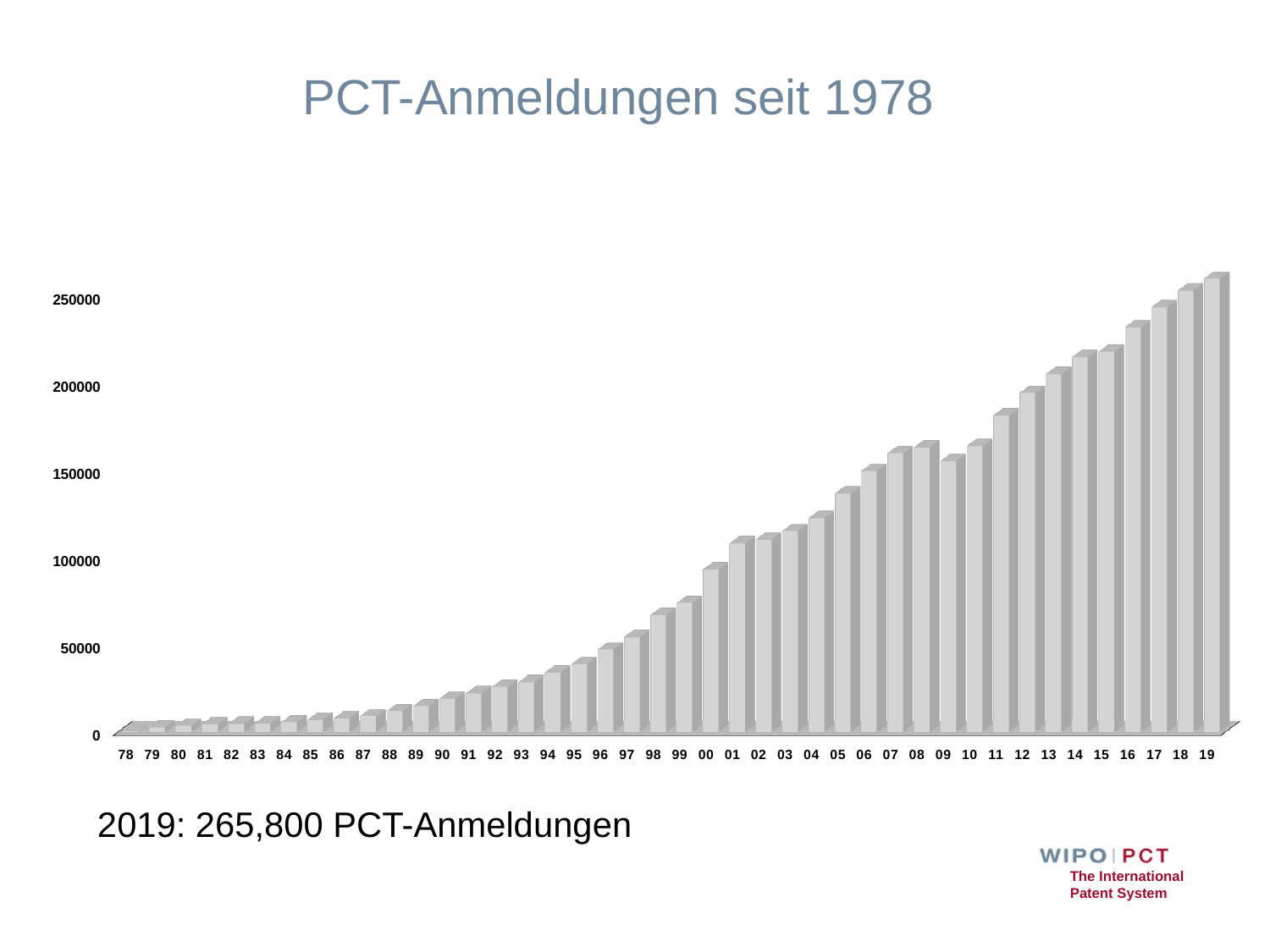
What kind of chart is shown on the slide? bar chart Which year has the highest number of PCT applications? 19 Which year has the larger value, 08 or 09? 08 Is the value for 13 greater or less than 200000? greater Do the values generally rise or fall from 78 to 19? rise Which year has the lowest number of PCT applications? 78 What is the title of the chart? PCT-Anmeldungen seit 1978 How many years (bars) are shown on the x axis? 42 Is the value for 00 greater or less than 100000? less How many PCT applications were filed in 2019, according to the slide? 265,800 Is the value for 90 greater or less than 50000? less